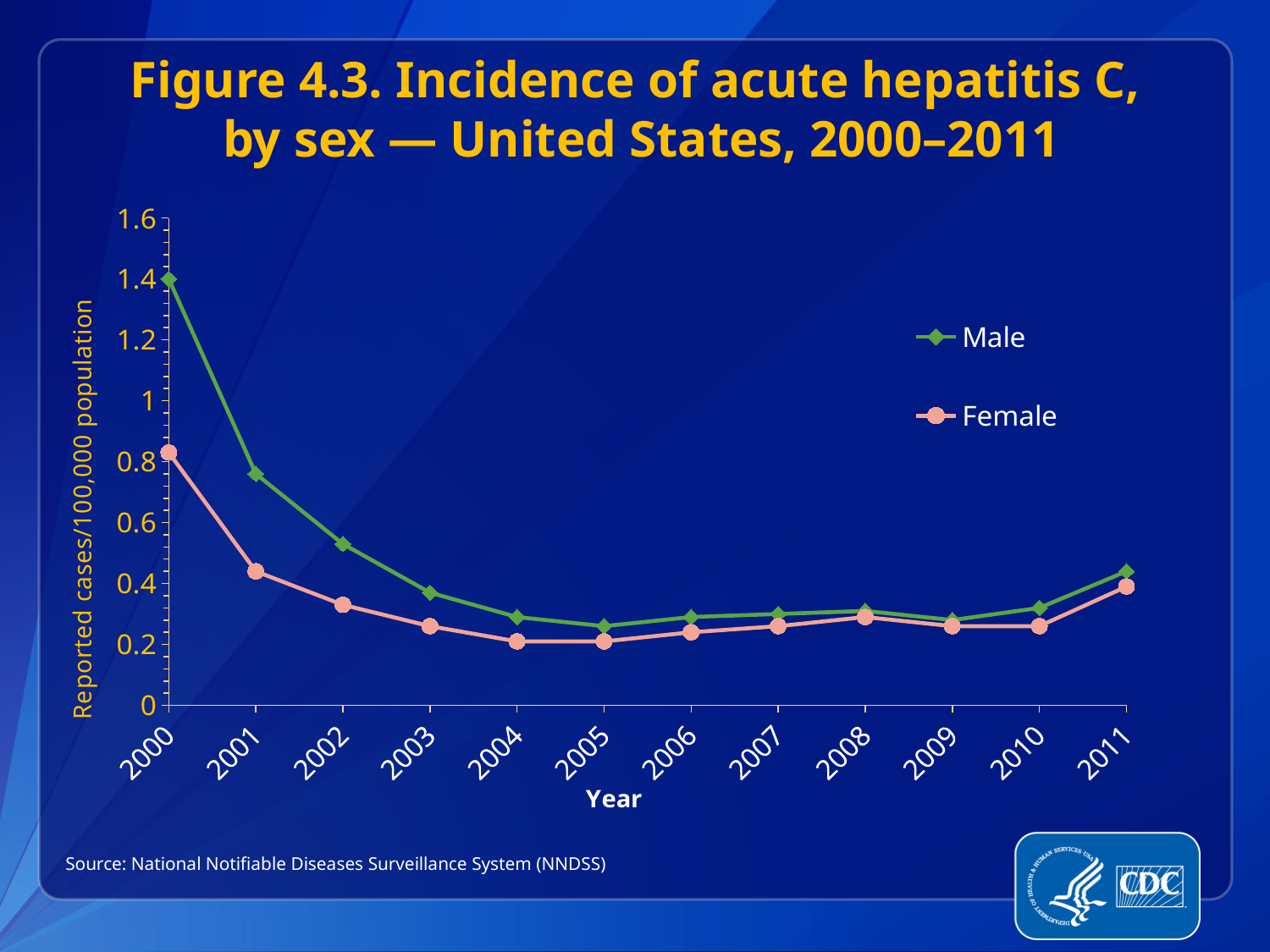
What is the Male incidence in 2000? 1.4 Is the Male value for 2002 greater or less than 0.6? less Which year has the highest Male incidence? 2000 Is the Male value for 2011 greater or less than 0.4? greater How many series does the legend list? 2 In 2000, which series has the larger value, Male or Female? Male Which series is drawn in green? Male Does the Male incidence rise or fall from 2000 to 2005? fall What kind of chart is shown on the slide? line chart Is the Male value for 2001 greater or less than 0.8? less How many years are plotted along the x axis? 12 What is the label of the y axis? Reported cases/100,000 population